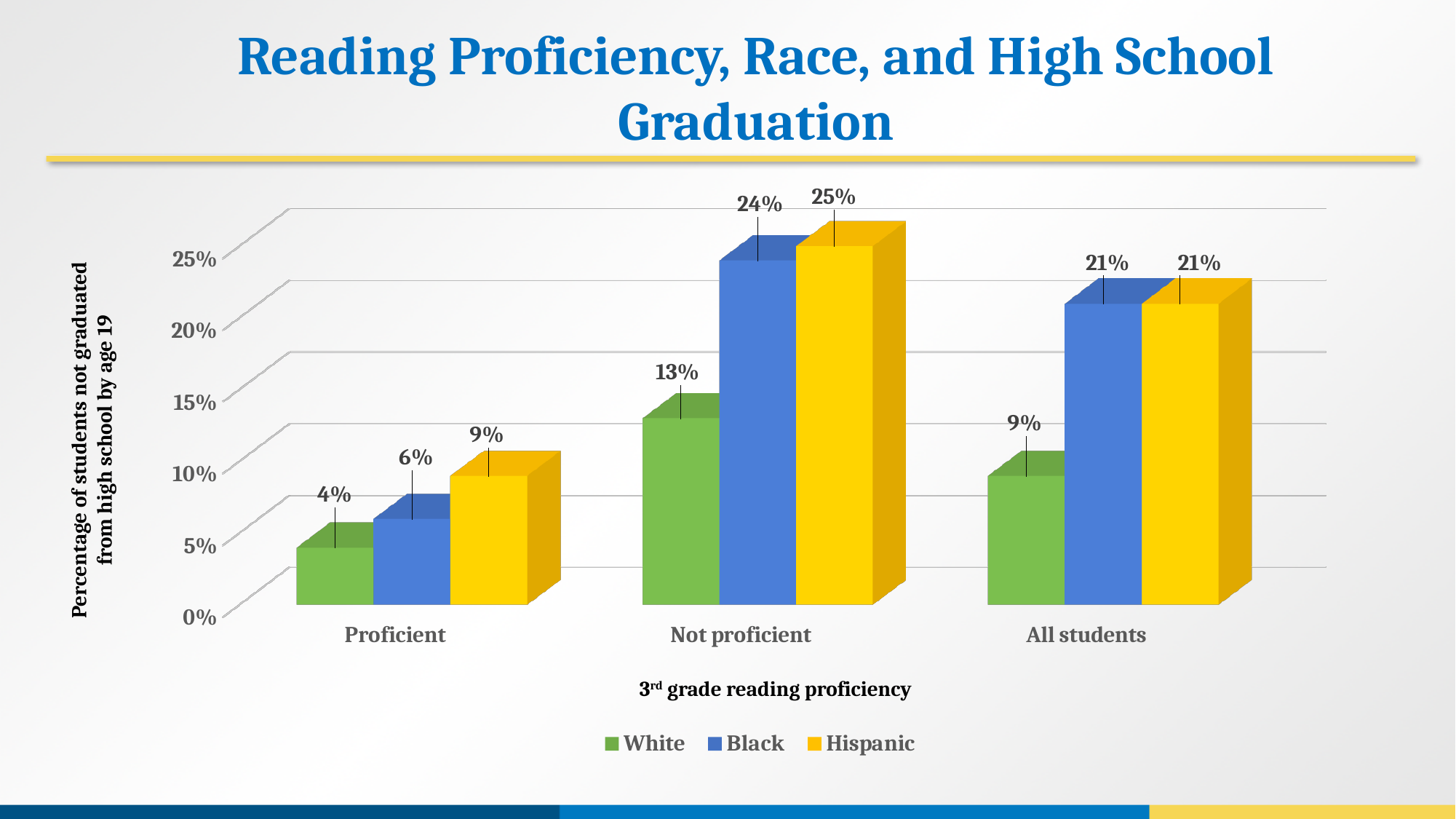
What kind of chart is shown on the slide? Bar chart What is the value for Black students in the All students category? 21% Which series has the highest value in the Not proficient category? Hispanic What is the value for White students in the Proficient category? 4% Which is larger: the Hispanic value for Proficient or the White value for All students? They are equal (both 9%) What is the value for Hispanic students in the Not proficient category? 25% What is the x-axis label of the chart? 3rd grade reading proficiency Which series has the lowest value in the Proficient category? White How many categories are shown on the x axis? 3 What is the title of the chart? Reading Proficiency, Race, and High School Graduation What is the difference between the Black and White values in the Not proficient category? 11% How many series does the legend list? 3